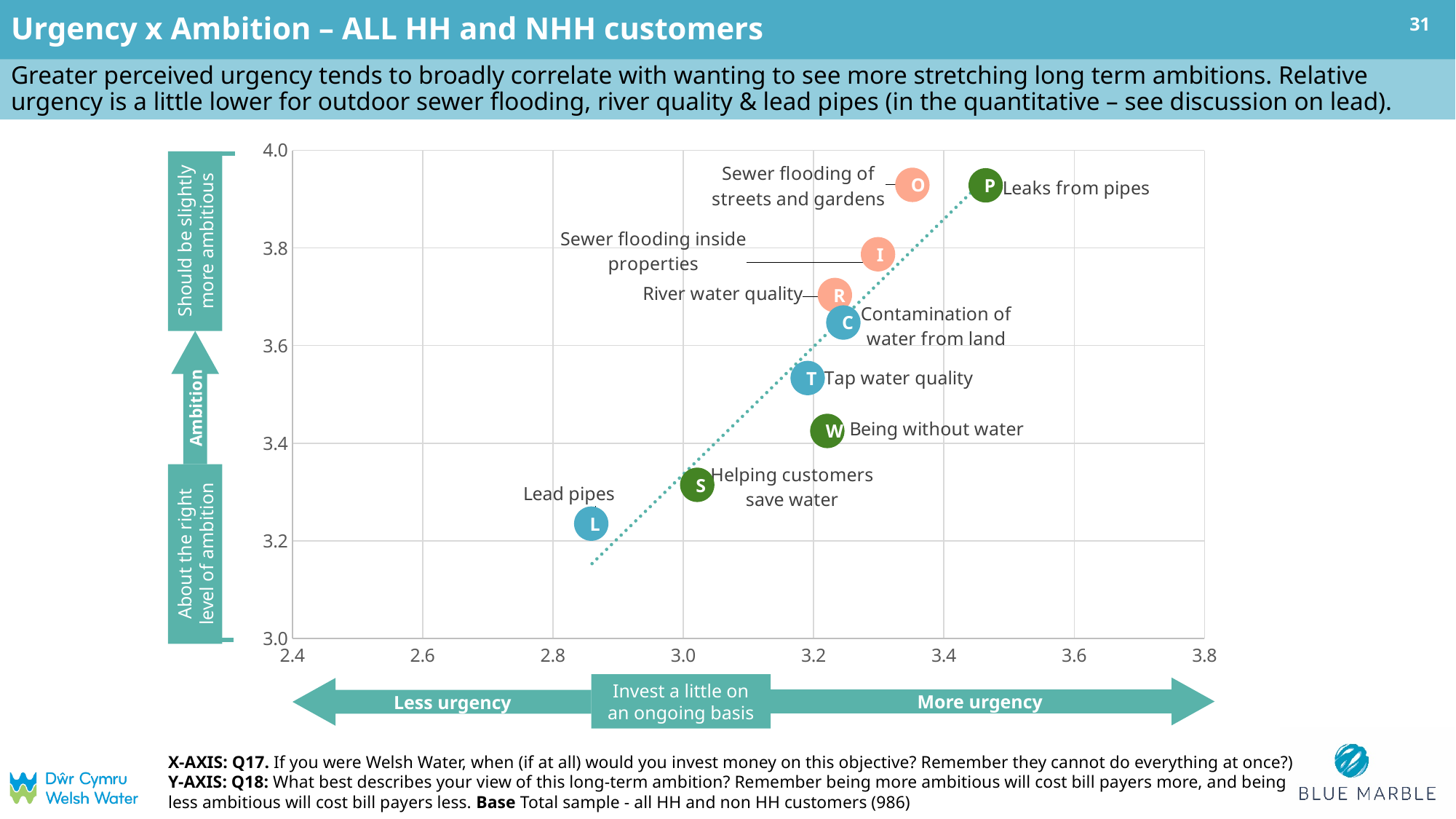
Is the urgency (x-axis) value for Lead pipes greater or less than 3.0? less How many objectives (points) are plotted on the chart? 9 Which has the higher ambition score: Tap water quality or Being without water? Tap water quality Is the ambition (y-axis) value for River water quality greater or less than 3.6? greater What is the title of the slide containing the chart? Urgency x Ambition – ALL HH and NHH customers Which objective has the highest urgency score (x-axis)? Leaks from pipes As urgency increases along the x-axis, does ambition generally rise or fall? Rise Which objective has the lowest urgency score (x-axis)? Lead pipes Is the ambition (y-axis) value for Leaks from pipes greater or less than 3.8? greater What kind of chart is shown on the slide? Scatter chart Which objective has the lowest ambition score (y-axis)? Lead pipes